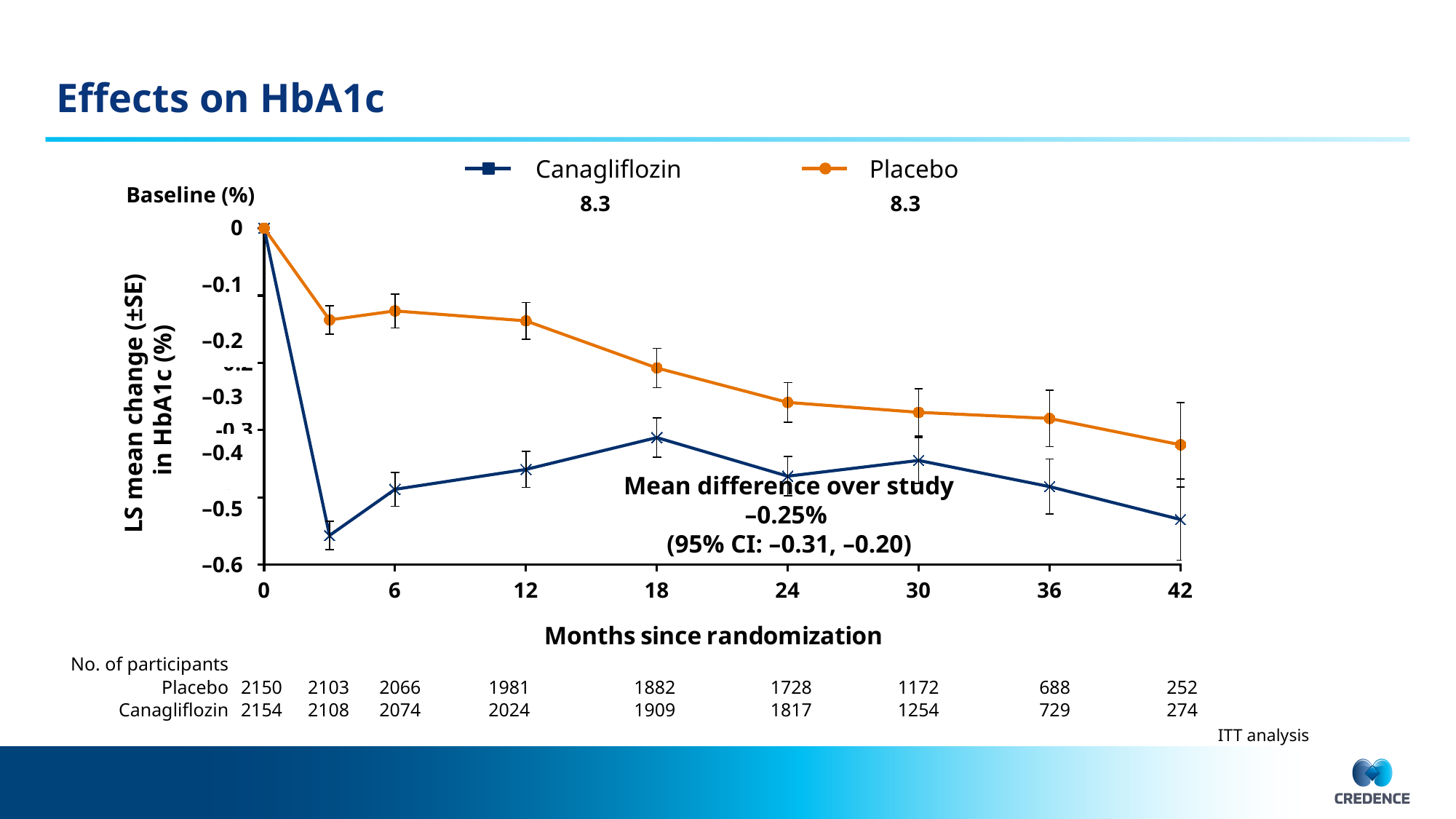
Is the Placebo value at 6 months greater or less than –0.2? greater What is the baseline HbA1c (%) shown for the Placebo group? 8.3 Does the Placebo line rise or fall from 6 months to 42 months? fall Is the Placebo value at 42 months greater or less than –0.3? less How many series does the legend list? 2 What is the mean difference over the study shown on the chart? –0.25% At 42 months, which series has the lower LS mean change in HbA1c? Canagliflozin What are the two series named in the legend? Canagliflozin and Placebo What is the 95% CI for the mean difference shown on the chart? (–0.31, –0.20) What kind of chart is shown on the slide? line chart How many participants are listed for Placebo at 42 months? 252